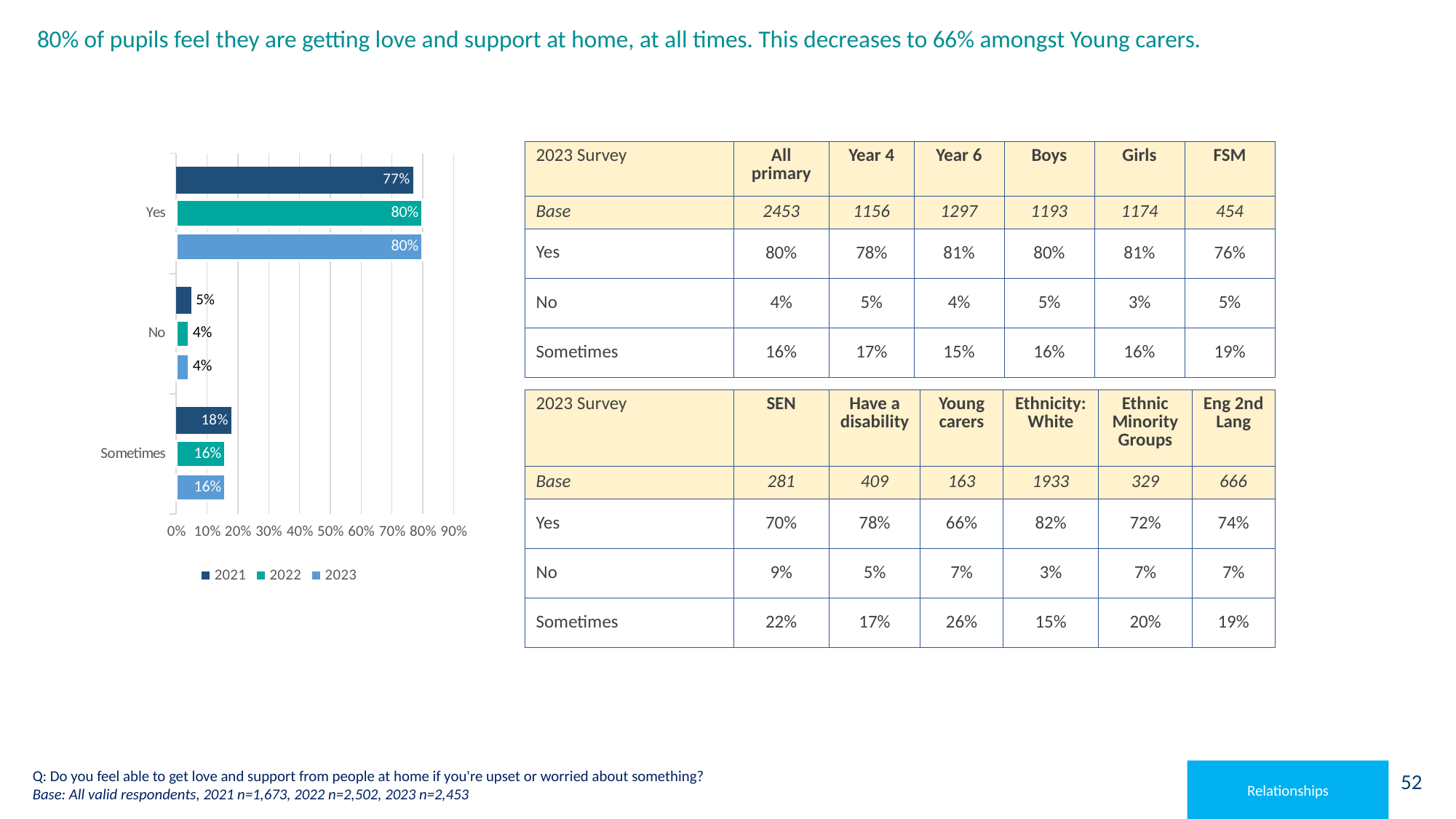
What is the value for 'No' in the 2021 series? 5% What kind of chart is shown on the slide? bar chart Which is larger: the 2021 value for 'Yes' or the 2022 value for 'Yes'? 2022 What is the difference between the 2021 and 2022 values for 'Sometimes'? 2% What is the value for 'Yes' in the 2021 series? 77% What is the value for 'Sometimes' in the 2022 series? 16% How many series does the chart legend list? 3 Which category has the highest value in the 2023 series? Yes Which category has the lowest value in the 2021 series? No What is the value for 'Yes' in the 2023 series? 80% Which series in the legend is shown in dark blue? 2021 How many categories are shown on the chart's vertical axis? 3